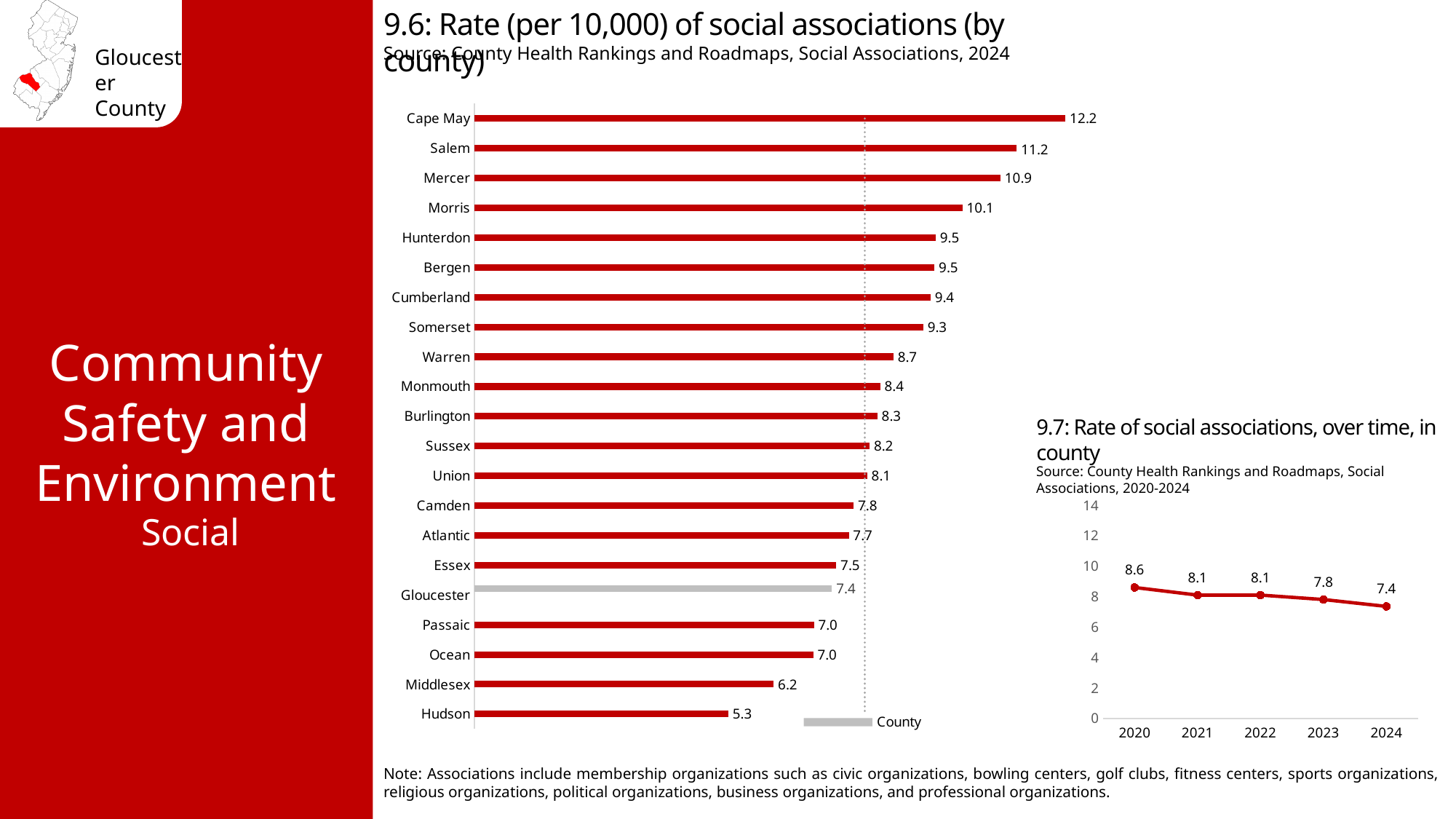
In chart 9.6 (rate of social associations by county), which county has the lowest rate? Hudson In chart 9.7 (rate of social associations over time), what is the value for 2020? 8.6 In chart 9.7 (rate of social associations over time), do the values rise or fall from 2020 to 2024? Fall In chart 9.7 (rate of social associations over time), what is the difference between the 2020 and 2024 values? 1.2 In chart 9.6 (rate of social associations by county), which is larger, the value for Mercer or the value for Morris? Mercer What kind of chart is chart 9.6 (rate of social associations by county)? Bar chart In chart 9.6 (rate of social associations by county), which county has the highest rate? Cape May In chart 9.6 (rate of social associations by county), how many counties are plotted? 21 In chart 9.6 (rate of social associations by county), what is the value for Middlesex? 6.2 In chart 9.6 (rate of social associations by county), what is the value for Gloucester? 7.4 In chart 9.7 (rate of social associations over time), how many years are plotted? 5 In chart 9.6 (rate of social associations by county), what is the difference between Cape May and Hudson? 6.9